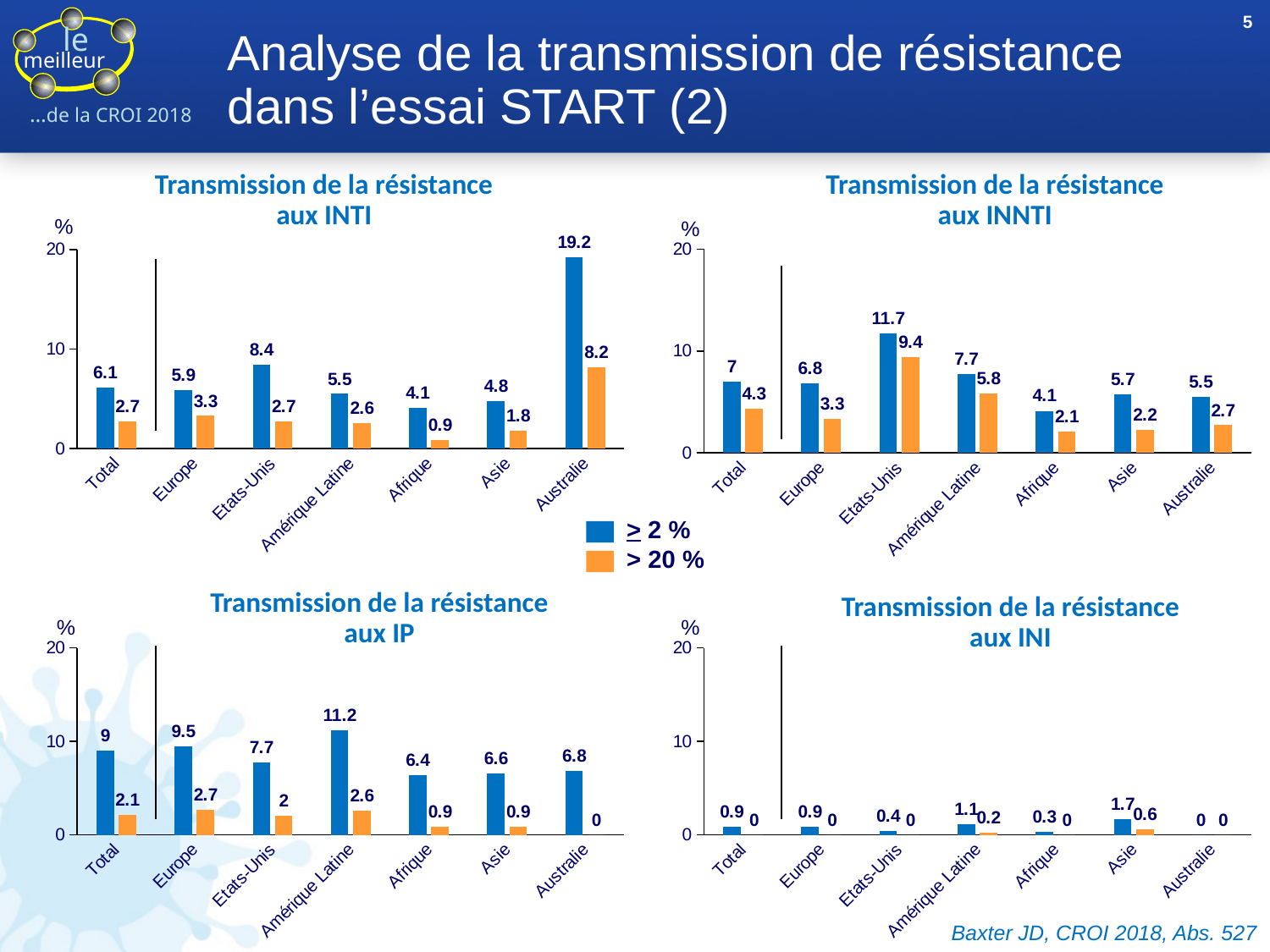
What type of chart is the 'Transmission de la résistance aux INTI' chart? Bar chart In the 'Transmission de la résistance aux INTI' chart, which category has the highest ≥ 2 % value? Australie In the 'Transmission de la résistance aux INNTI' chart, what is the > 20 % value for Etats-Unis? 9.4 In the 'Transmission de la résistance aux INNTI' chart, which category has the lowest ≥ 2 % value? Afrique In the 'Transmission de la résistance aux INI' chart, which category has the highest ≥ 2 % value? Asie In the 'Transmission de la résistance aux INTI' chart, what is the value of the ≥ 2 % series for Australie? 19.2 How many categories are shown on the x axis of the 'Transmission de la résistance aux IP' chart? 7 In the 'Transmission de la résistance aux INNTI' chart, which is larger, the ≥ 2 % value for Amérique Latine or for Asie? Amérique Latine In the 'Transmission de la résistance aux INTI' chart, what is the difference between the ≥ 2 % and > 20 % values for Australie? 11 In the 'Transmission de la résistance aux IP' chart, what is the ≥ 2 % value for Amérique Latine? 11.2 In the 'Transmission de la résistance aux IP' chart, what is the > 20 % value for Australie? 0 In the 'Transmission de la résistance aux INI' chart, what is the > 20 % value for Amérique Latine? 0.2